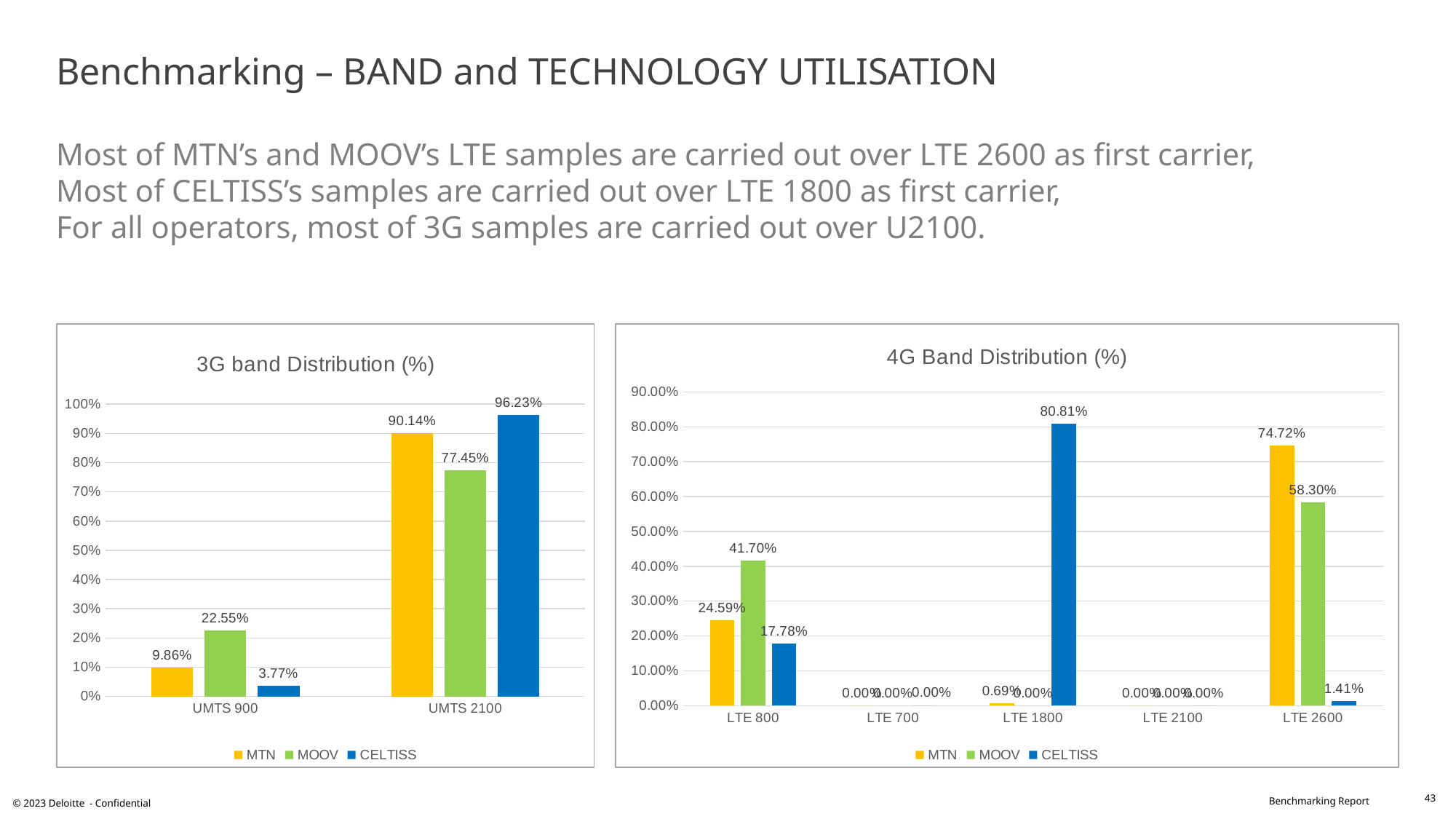
In the 3G band Distribution (%) chart, what is the value for CELTISS at UMTS 2100? 96.23% How many series does the legend of the 3G band Distribution (%) chart list? 3 How many band categories are shown on the x axis of the 4G Band Distribution (%) chart? 5 In the 4G Band Distribution (%) chart, which is larger at LTE 800: the MTN value or the CELTISS value? MTN In the 4G Band Distribution (%) chart, what is the value for CELTISS at LTE 1800? 80.81% In the 4G Band Distribution (%) chart, what is the value for MTN at LTE 2600? 74.72% In the 3G band Distribution (%) chart, what is the difference between the MTN values at UMTS 2100 and UMTS 900? 80.28% In the 4G Band Distribution (%) chart, which operator has the highest value at LTE 800? MOOV What kind of chart is the 4G Band Distribution (%) chart? Bar chart In the 4G Band Distribution (%) chart, what is the difference between the MTN and MOOV values at LTE 2600? 16.42% In the 3G band Distribution (%) chart, which operator has the lowest value at UMTS 900? CELTISS In the 3G band Distribution (%) chart, what is the value for MOOV at UMTS 900? 22.55%